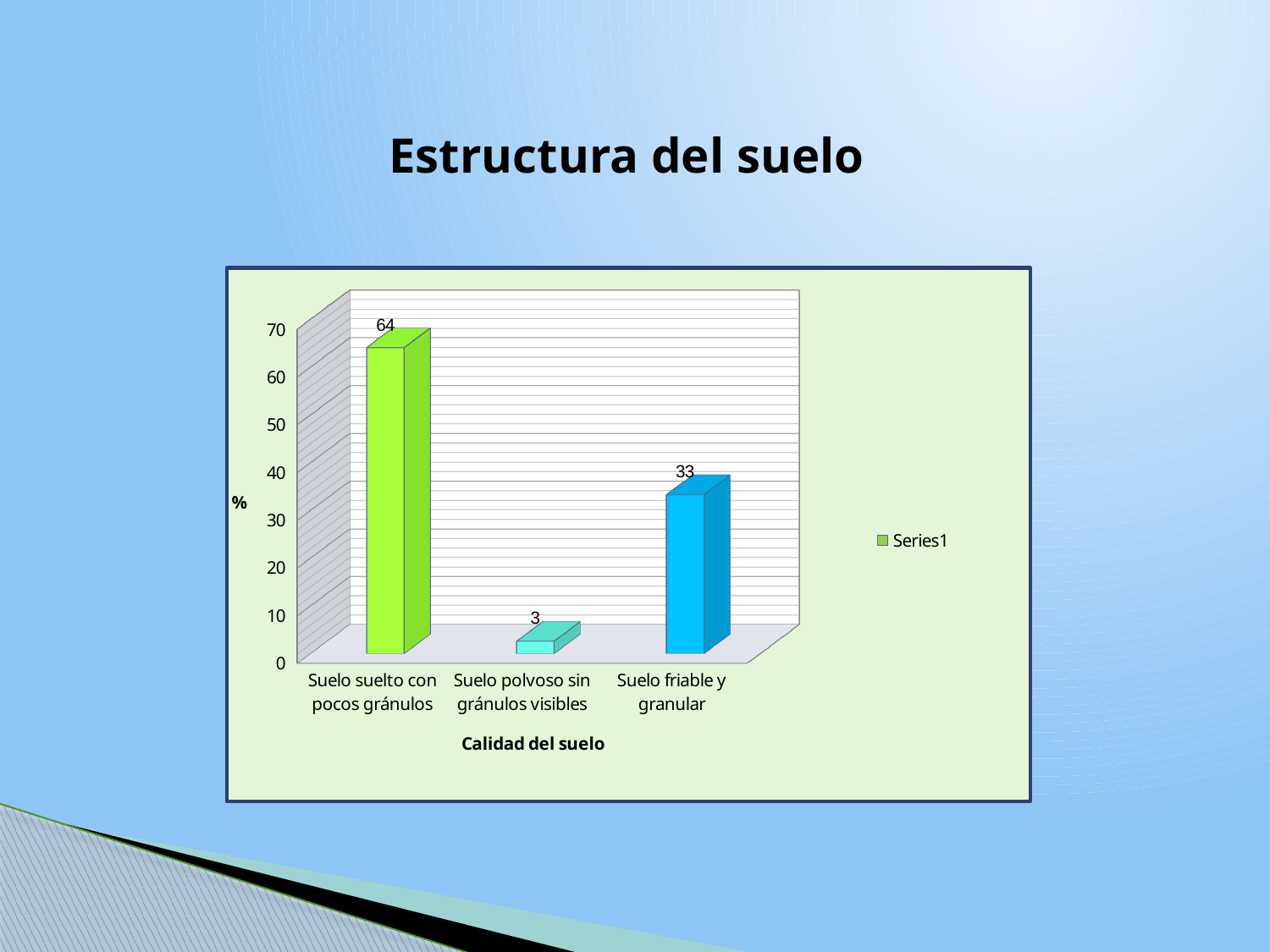
What is the value for "Suelo polvoso sin gránulos visibles"? 3 What kind of chart is shown on the slide? bar chart Is the value for "Suelo friable y granular" greater or less than 40? less What is the difference between the values for "Suelo suelto con pocos gránulos" and "Suelo friable y granular"? 31 Which category has the lowest value? Suelo polvoso sin gránulos visibles How many series does the legend list? 1 What is the value for "Suelo friable y granular"? 33 What is the value for "Suelo suelto con pocos gránulos"? 64 Which category has the highest value? Suelo suelto con pocos gránulos What is the label of the x axis? Calidad del suelo Which is larger, the value for "Suelo friable y granular" or the value for "Suelo polvoso sin gránulos visibles"? Suelo friable y granular How many categories are shown on the x axis? 3